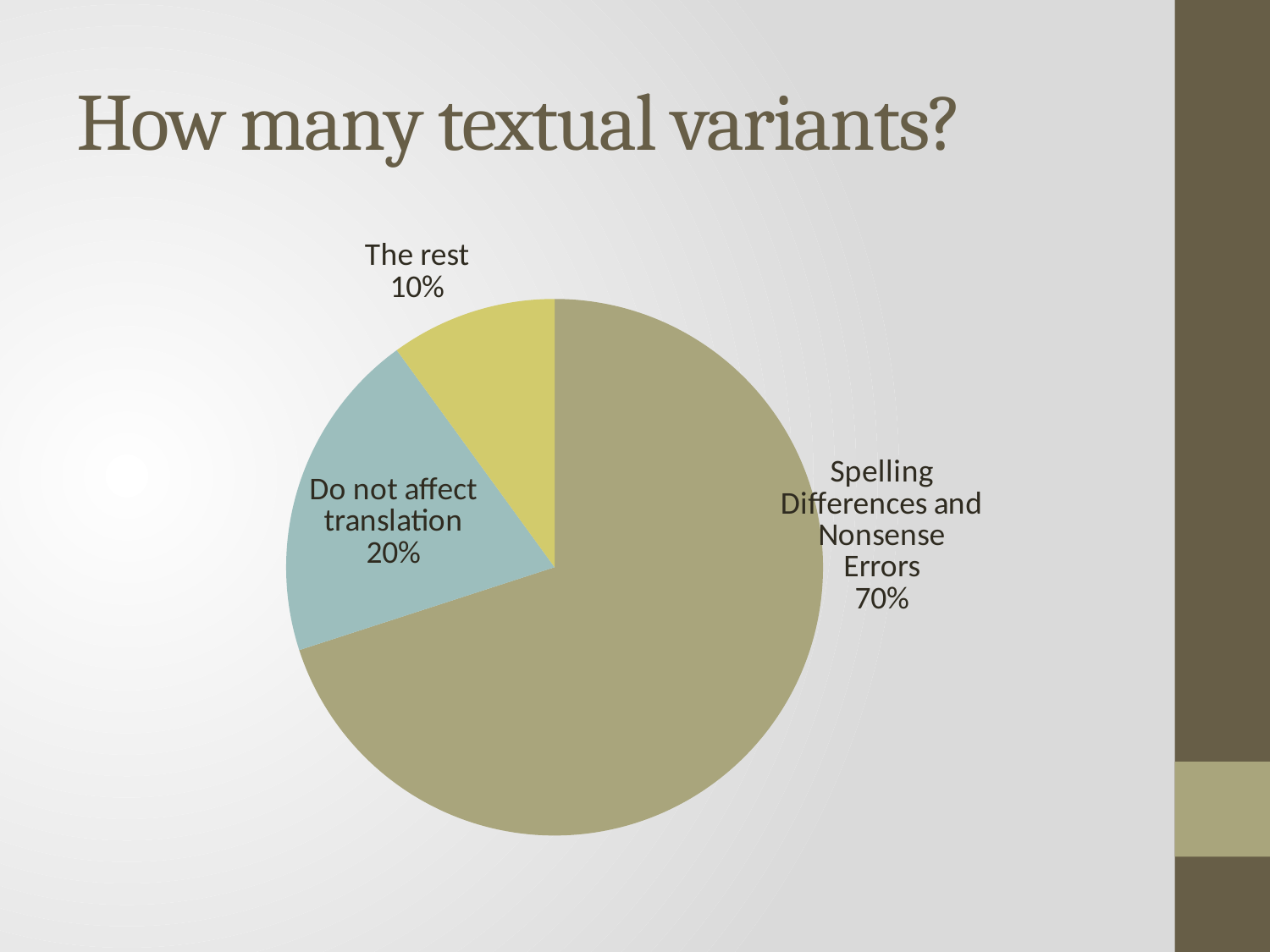
What is the title of the slide containing the pie chart? How many textual variants? How many slices does the pie chart have? 3 What share of the pie is labelled "Spelling Differences and Nonsense Errors"? 70% Which slice of the pie is the smallest? The rest Which is larger: the "Do not affect translation" slice or "The rest" slice? Do not affect translation What colour is the "Do not affect translation" slice? light blue-grey What share of the pie is labelled "The rest"? 10% What is the difference in percentage points between the "Spelling Differences and Nonsense Errors" slice and the "Do not affect translation" slice? 50 percentage points What share of the pie is labelled "Do not affect translation"? 20% Which slice of the pie is the largest? Spelling Differences and Nonsense Errors What kind of chart is shown on the slide? pie chart What is the difference in percentage points between the "Do not affect translation" slice and "The rest" slice? 10 percentage points